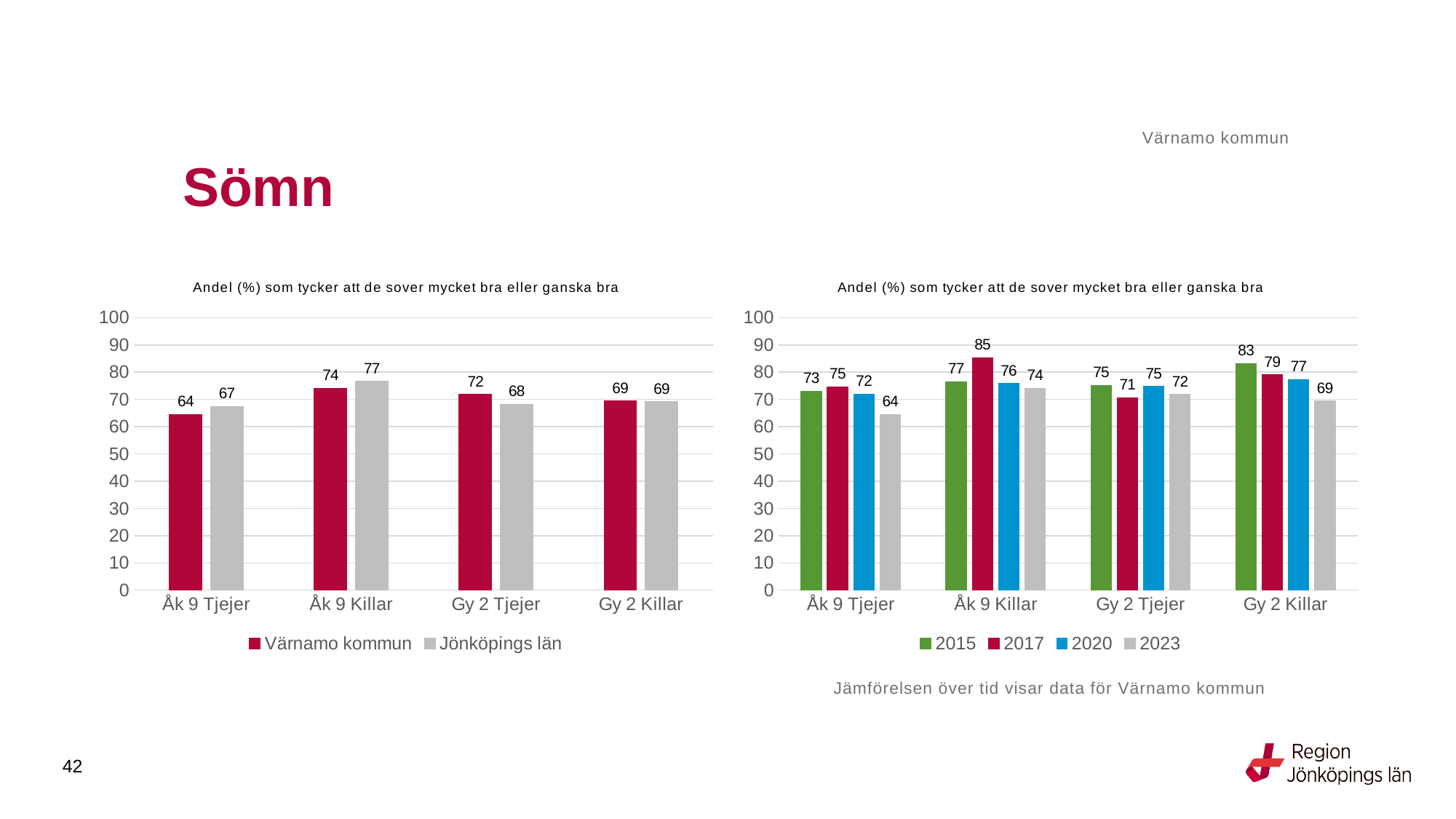
In the left chart, which category has the lowest value for Värnamo kommun? Åk 9 Tjejer In the left chart, how many series does the legend list? 2 In the left chart, how many categories are shown on the x axis? 4 In the right chart, which category has the highest value for 2015? Gy 2 Killar In the right chart, what is the difference between the 2015 and 2023 values for Gy 2 Killar? 14 In the right chart, what is the value for 2017 for Åk 9 Killar? 85 In the left chart, what is the value for Värnamo kommun for Åk 9 Tjejer? 64 In the left chart, what is the value for Jönköpings län for Åk 9 Killar? 77 In the right chart, how many series does the legend list? 4 In the left chart, what is the difference between Jönköpings län and Värnamo kommun for Gy 2 Tjejer? 4 What kind of chart is the right chart? Bar chart In the right chart, what is the value for 2023 for Åk 9 Tjejer? 64